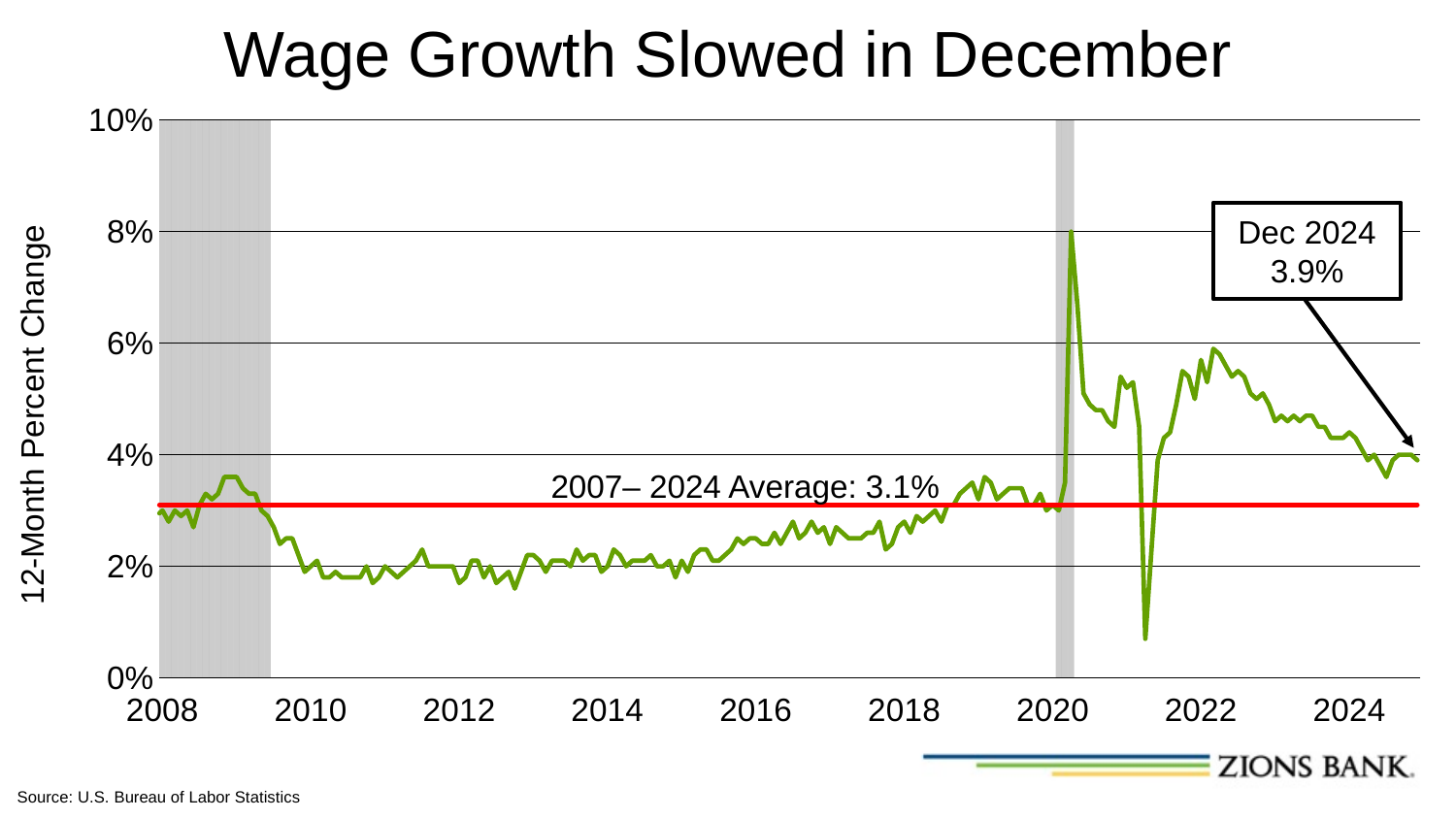
What is the title of the chart? Wage Growth Slowed in December By how many percentage points does the Dec 2024 value exceed the 2007–2024 average? 0.8 percentage points In which year does the line reach its highest point? 2020 What is the 2007–2024 average shown by the red line? 3.1% Which is larger, the Dec 2024 value or the 2007–2024 average? Dec 2024 value Is the lowest value reached in 2021 greater or less than 2%? less Is the peak value reached in 2020 greater or less than 6%? greater What is the value labeled for Dec 2024? 3.9% What kind of chart is shown on the slide? Line chart Is the value during 2012 greater or less than 4%? less Does the line generally rise or fall from 2022 to 2024? Fall What is the label on the vertical axis? 12-Month Percent Change